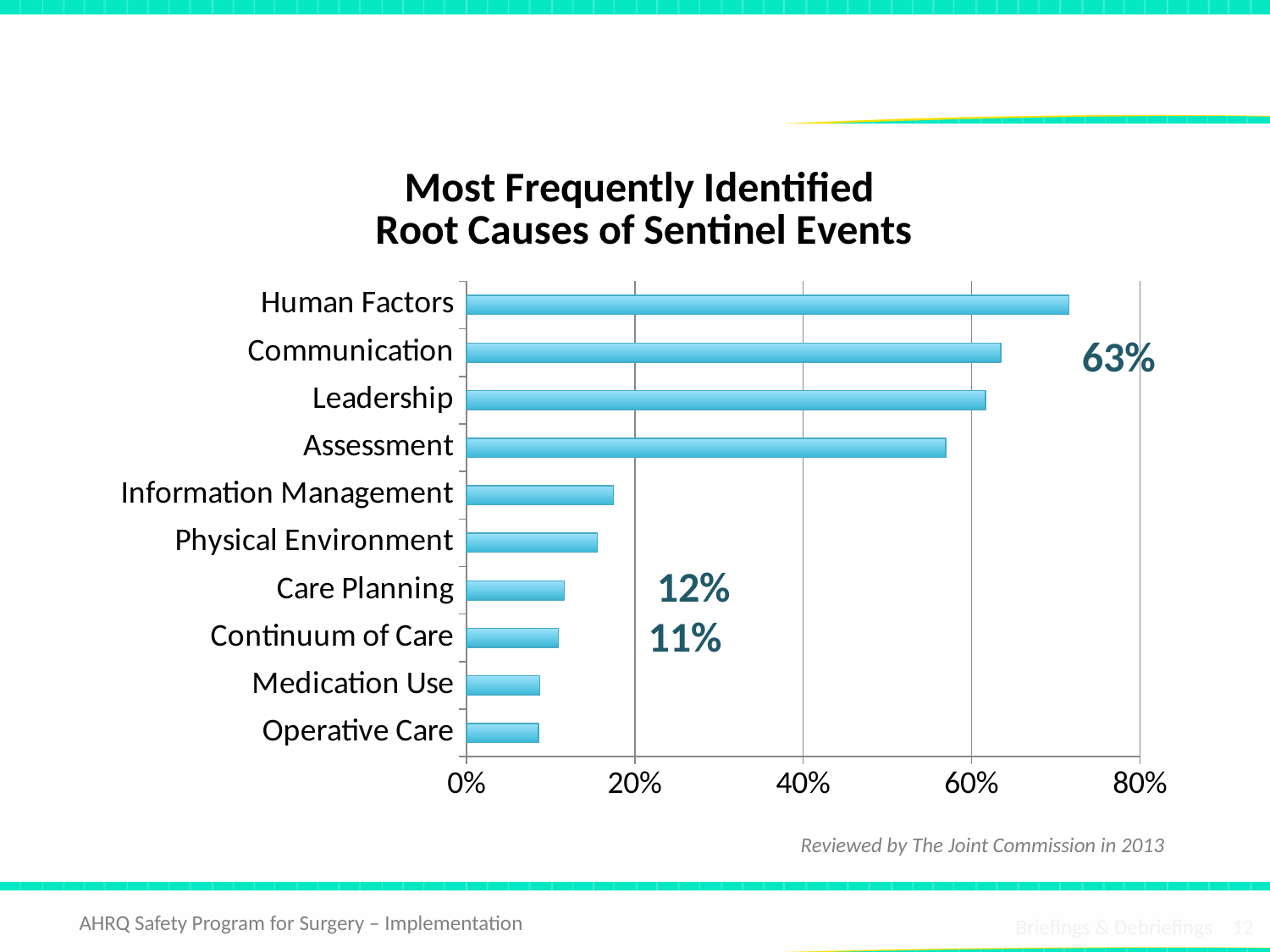
What is the title of the chart? Most Frequently Identified Root Causes of Sentinel Events What value is labelled for Continuum of Care? 11% What type of chart is shown on the slide? Bar chart How many root-cause categories are plotted in the chart? 10 Is the value for Information Management greater or less than 20%? less Which is larger, the value for Human Factors or the value for Assessment? Human Factors Do the bar values increase or decrease going from the top category to the bottom category? Decrease Is the value for Assessment greater or less than 60%? less What value is labelled for Communication? 63% What value is labelled for Care Planning? 12% Is the value for Human Factors greater or less than 60%? greater Which root cause has the highest value in the chart? Human Factors